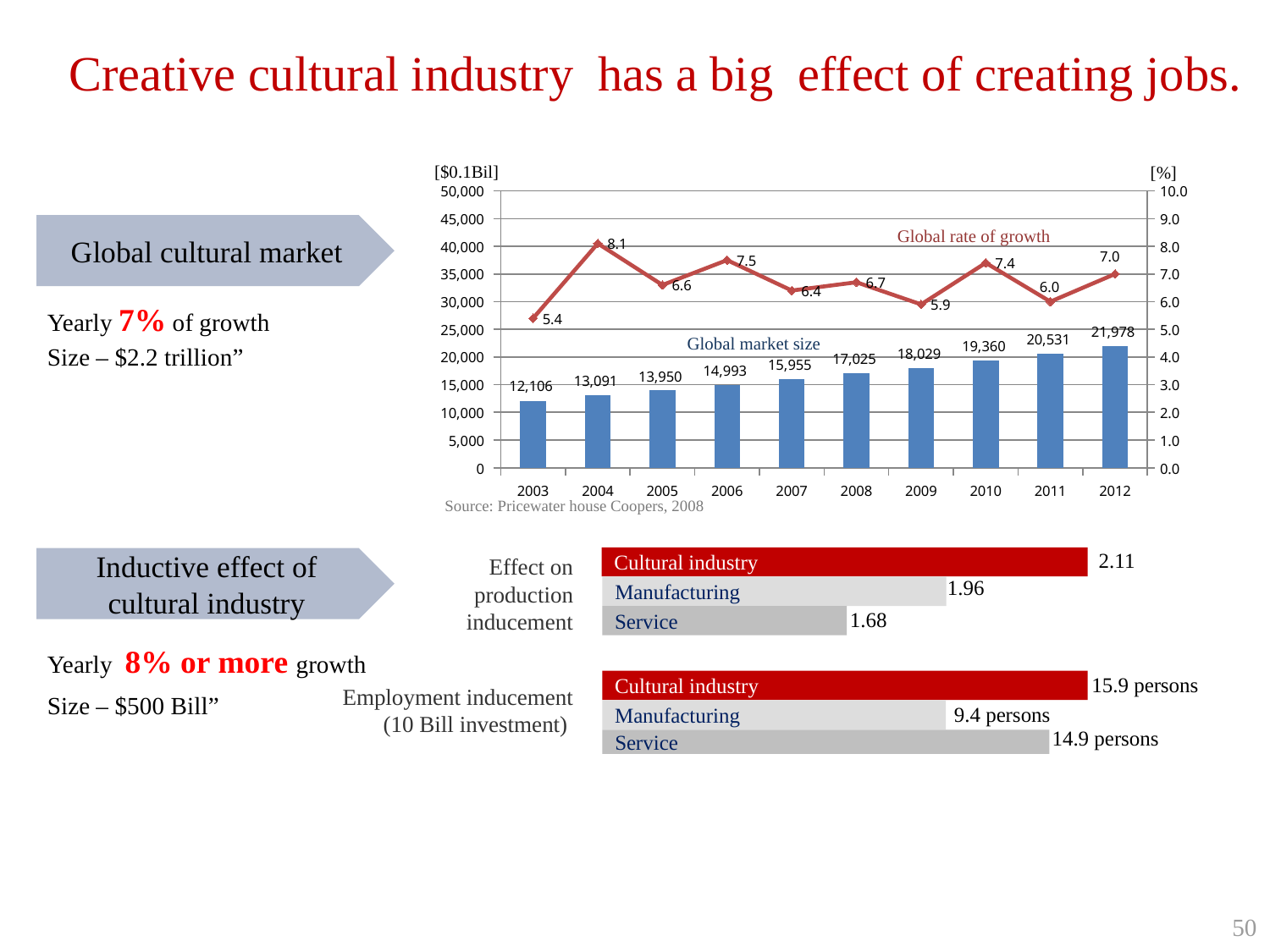
How many years are shown on the x axis of the Global cultural market chart? 10 In the Global cultural market chart, what is the global rate of growth for 2004? 8.1 What unit is shown on the left axis of the Global cultural market chart? [$0.1Bil] In the Effect on production inducement chart, which category has the highest value? Cultural industry In the Global cultural market chart, which year has the highest global rate of growth? 2004 In the Global cultural market chart, what is the global market size for 2008? 17,025 In the Global cultural market chart, which year has the higher global rate of growth, 2006 or 2007? 2006 In the Global cultural market chart, what is the difference between the global market size in 2012 and in 2003? 9,872 In the Global cultural market chart, which year has the lowest global rate of growth? 2003 What kind of chart is the Global cultural market chart? combination bar and line chart In the Global cultural market chart, do the global market size bars rise or fall from 2003 to 2012? rise In the Employment inducement chart at the bottom of the slide, what is the value for Cultural industry? 15.9 persons